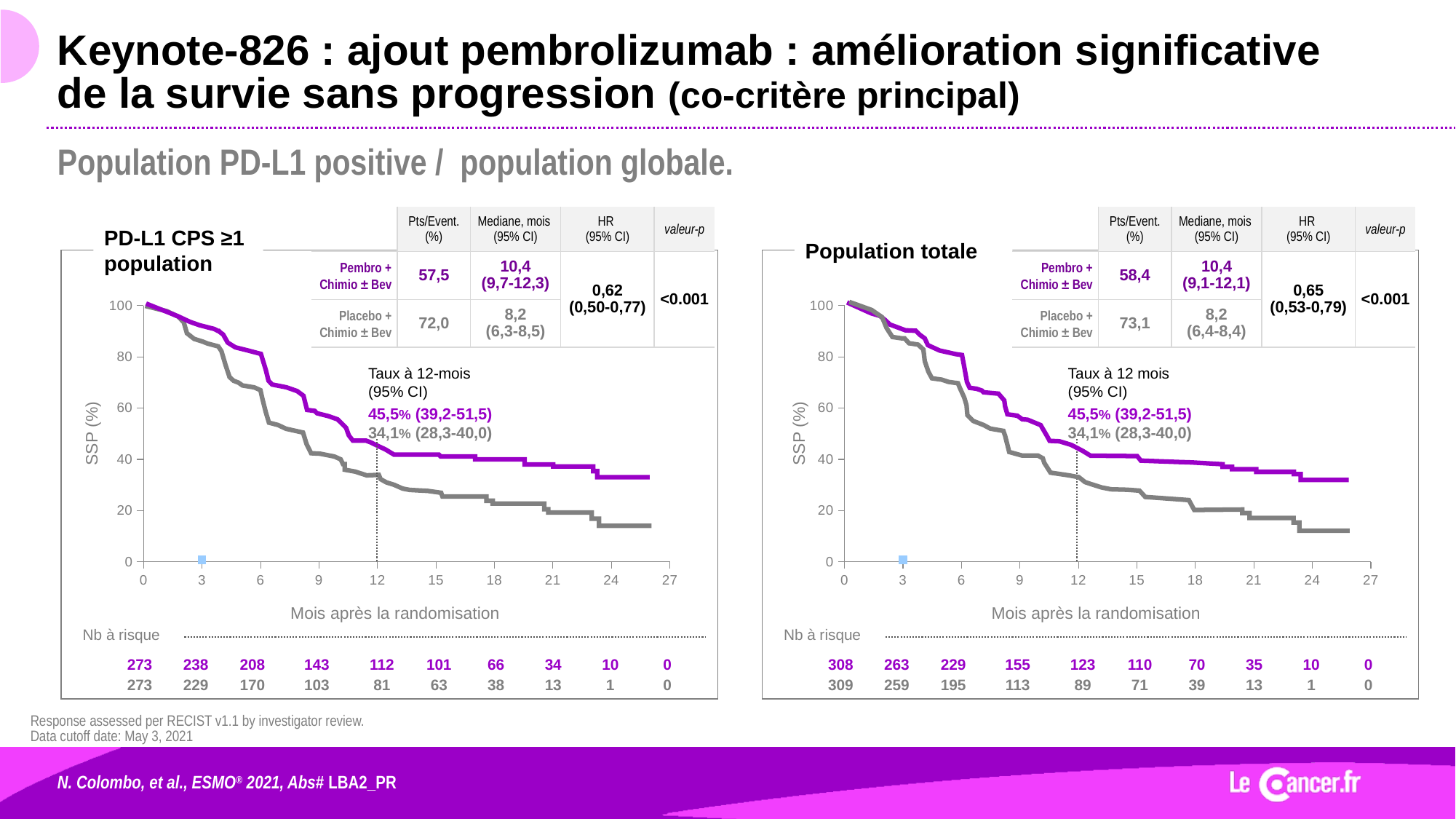
In the Population totale chart, which arm has the higher 12-month SSP rate, Pembro + Chimio ± Bev or Placebo + Chimio ± Bev? Pembro + Chimio ± Bev In the Population totale chart, how many patients were at risk in the Placebo + Chimio ± Bev arm at 9 months? 113 In the Population totale chart, do the SSP curves rise or fall as months after randomisation increase? Fall In the PD-L1 CPS ≥1 population chart, is the grey curve's value at 24 months greater or less than 20? less In the Population totale chart, what is the difference between the 12-month SSP rates of the two curves? 11,4 percentage points In the PD-L1 CPS ≥1 population chart, what is the 12-month SSP rate for the purple (Pembro + Chimio ± Bev) curve? 45,5% What kind of chart is the PD-L1 CPS ≥1 population chart? Line chart (Kaplan-Meier survival curve) In the PD-L1 CPS ≥1 population chart, what is the median SSP in months for the Placebo + Chimio ± Bev arm? 8,2 (6,3-8,5) In the PD-L1 CPS ≥1 population chart, what is the 12-month SSP rate for the grey (Placebo + Chimio ± Bev) curve? 34,1% In the Population totale chart, is the purple curve's value at 24 months greater or less than 20? greater In the PD-L1 CPS ≥1 population chart, how many patients were at risk in the Pembro + Chimio ± Bev arm at 12 months? 112 In the Population totale chart, what is the hazard ratio shown in the table? 0,65 (0,53-0,79)